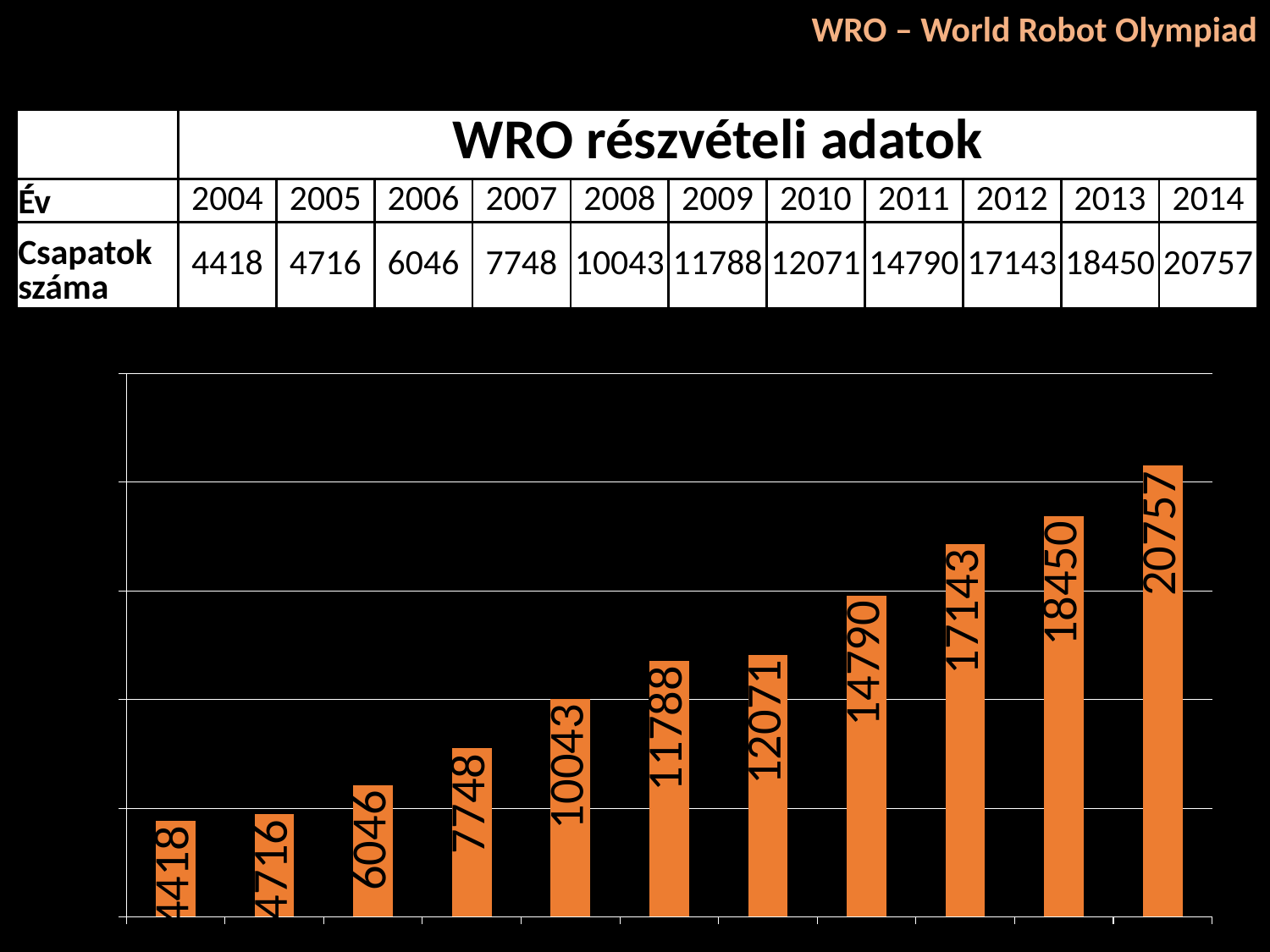
How many bars does the chart contain? 11 What kind of chart is shown on the slide? bar chart What is the title of the table above the chart? WRO részvételi adatok Do the bar values rise or fall from left to right across the chart? rise What is the difference between the bars labelled 18450 and 17143? 1307 What is the value labelled on the fifth bar from the left? 10043 What is the value shown on the shortest bar in the chart? 4418 What is the difference between the values on the last bar (20757) and the first bar (4418)? 16339 According to the table, how many teams (Csapatok száma) took part in 2011? 14790 Which is larger, the bar labelled 7748 or the bar labelled 6046? 7748 What is the value shown on the tallest bar in the chart? 20757 What is the value labelled on the seventh bar from the left? 12071